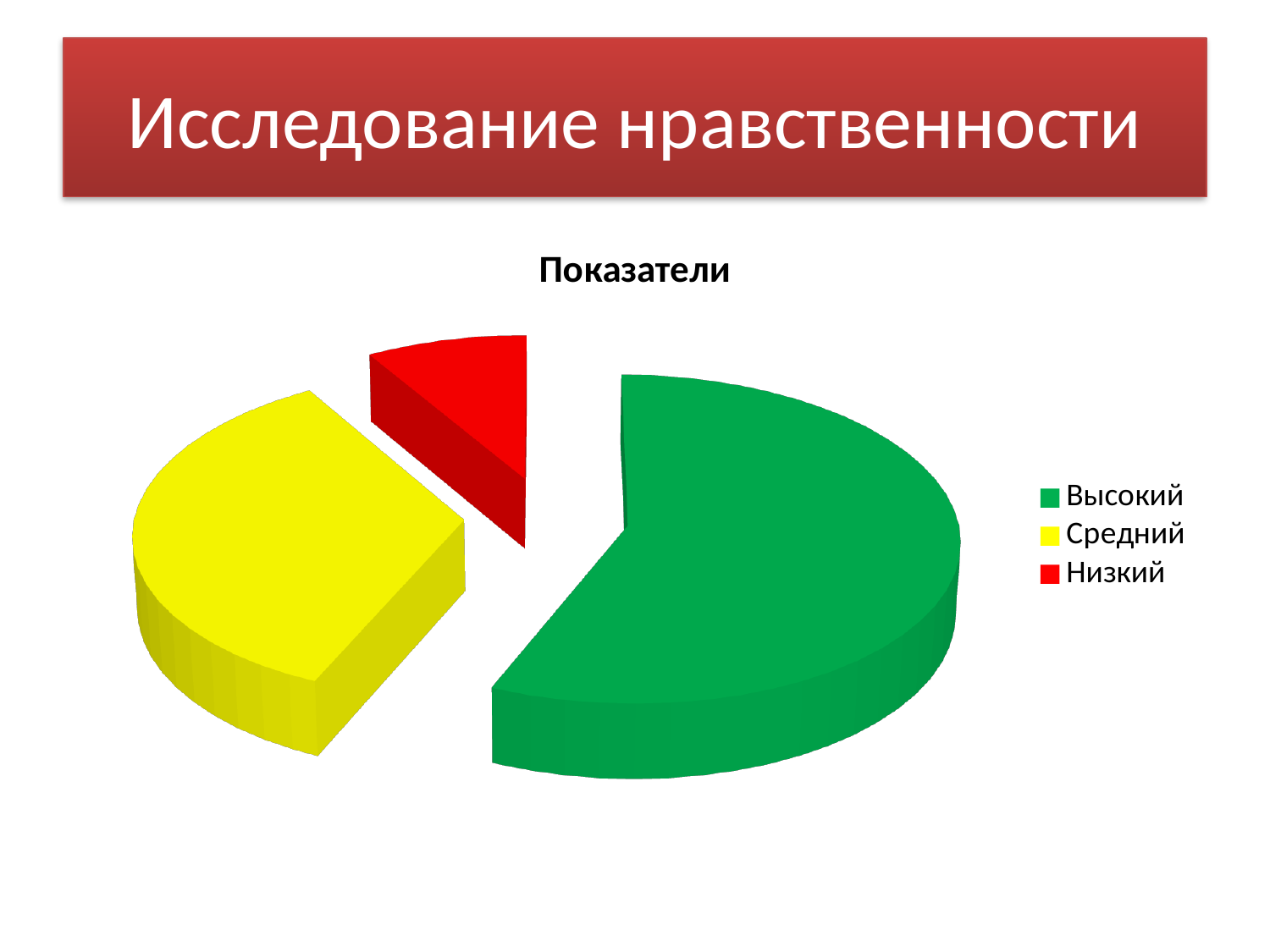
Which category has the largest slice of the pie? Высокий Which slice is larger, Средний or Низкий? Средний Which category has the smallest slice of the pie? Низкий What kind of chart is shown on the slide? Pie chart How many entries does the legend list? 3 How many slices does the pie chart have? 3 What is the title of the chart? Показатели Which slice is larger, Высокий or Средний? Высокий What colour is the slice for Низкий? Red